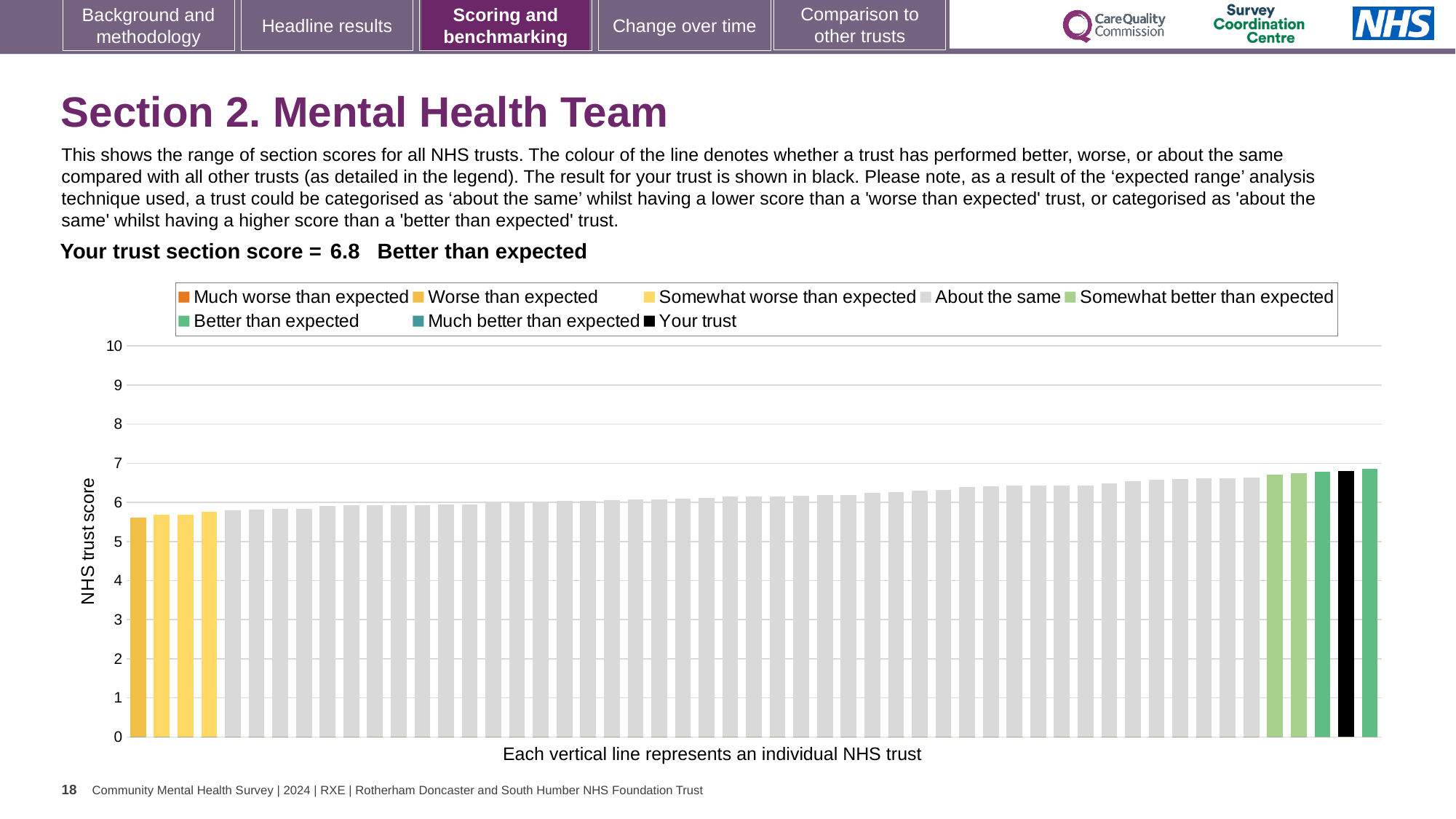
Is the value of the lowest bar in the chart greater or less than 6? less What colour is used for the bar representing your trust? Black What kind of chart is shown on the slide? Bar chart Do the bar values rise or fall from left to right along the x axis? Rise How many bars are coloured in the 'Somewhat worse than expected' light yellow colour? 3 What is the label on the vertical axis of the chart? NHS trust score What is the section score for your trust shown on the slide? 6.8 Is the value of the highest bar in the chart greater or less than 7? less Is the value for your trust (the black bar) greater or less than 6? greater Which performance category is your trust's section score assigned to? Better than expected How many entries does the chart legend list? 8 Is the black bar for your trust the highest bar in the chart? No